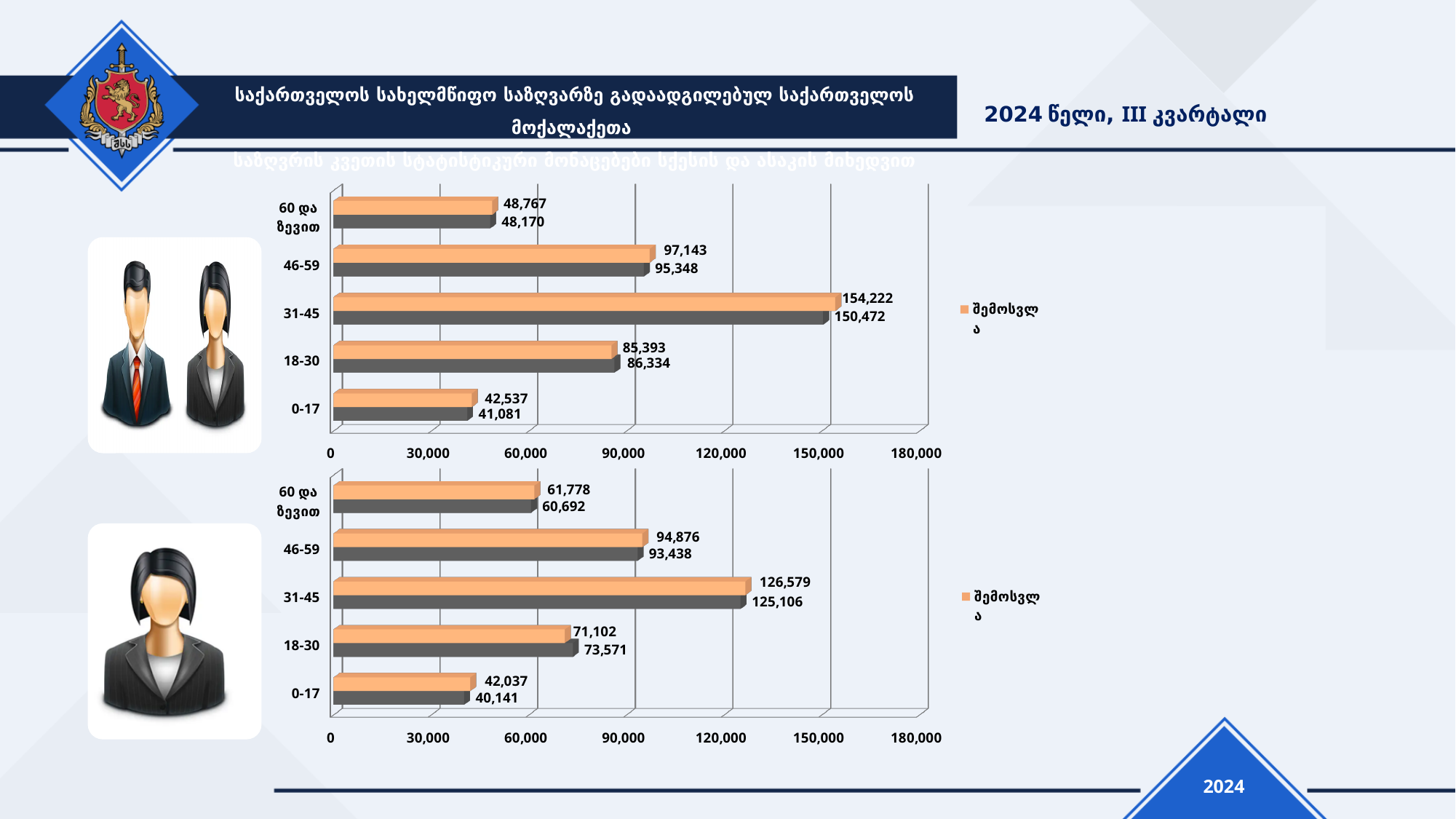
How many age-group categories are shown in the bottom chart? 5 In the top chart, which age group has the highest orange (შემოსვლა) value? 31-45 In the top chart, for the 18-30 age group, which is larger: the orange bar or the grey bar? the grey bar (86,334) In the bottom chart, what is the value of the grey bar for the 18-30 age group? 73,571 In the top chart, what is the difference between the orange and grey values for the 31-45 age group? 3,750 In the top chart, what is the value of the grey bar for the '60 და ზევით' age group? 48,170 What type of chart is the top chart? bar chart In the bottom chart, what is the value of the orange (შემოსვლა) bar for the 0-17 age group? 42,037 In the bottom chart, what is the difference between the orange (შემოსვლა) values for the 31-45 and 46-59 age groups? 31,703 In the top chart, is the orange (შემოსვლა) value for the 46-59 age group greater or less than 90,000? greater In the bottom chart, which age group has the lowest grey bar value? 0-17 In the top chart, what is the value of the orange (შემოსვლა) bar for the 31-45 age group? 154,222